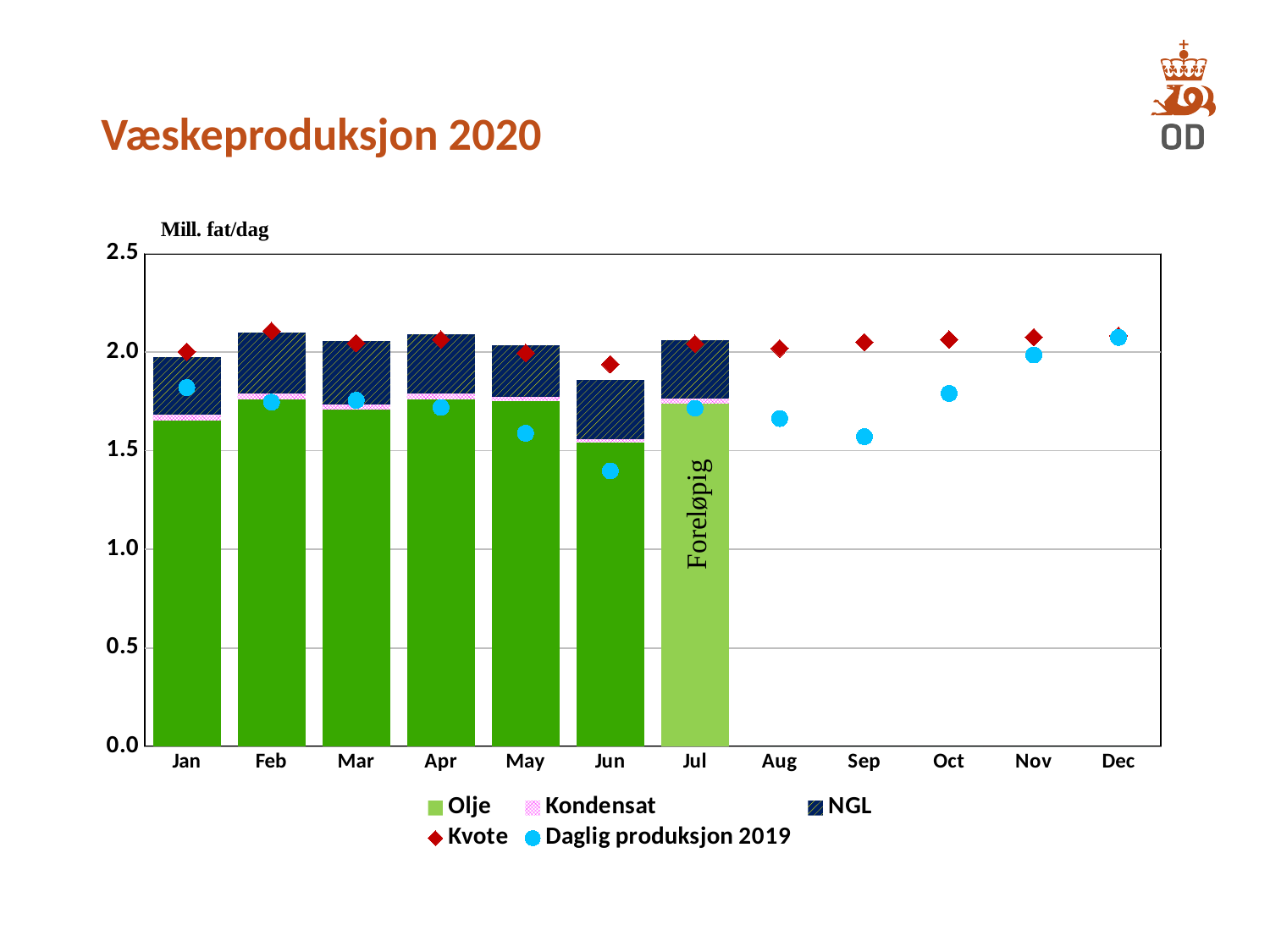
What unit is shown above the y axis? Mill. fat/dag How many months are shown on the x axis? 12 Which is larger in Jun, the Kvote value or the Daglig produksjon 2019 value? Kvote How many months have a stacked bar plotted? 7 Which month has the lowest stacked bar? Jun In which month is the Daglig produksjon 2019 value lowest? Jun What kind of chart is shown on the slide? bar chart Is the Daglig produksjon 2019 value for Jun greater or less than 1.5? less In which month is the Daglig produksjon 2019 value highest? Dec Is the total of the stacked bar for Jun greater or less than 2.0? less How many series does the legend list? 5 In which month is the Kvote value lowest? Jun